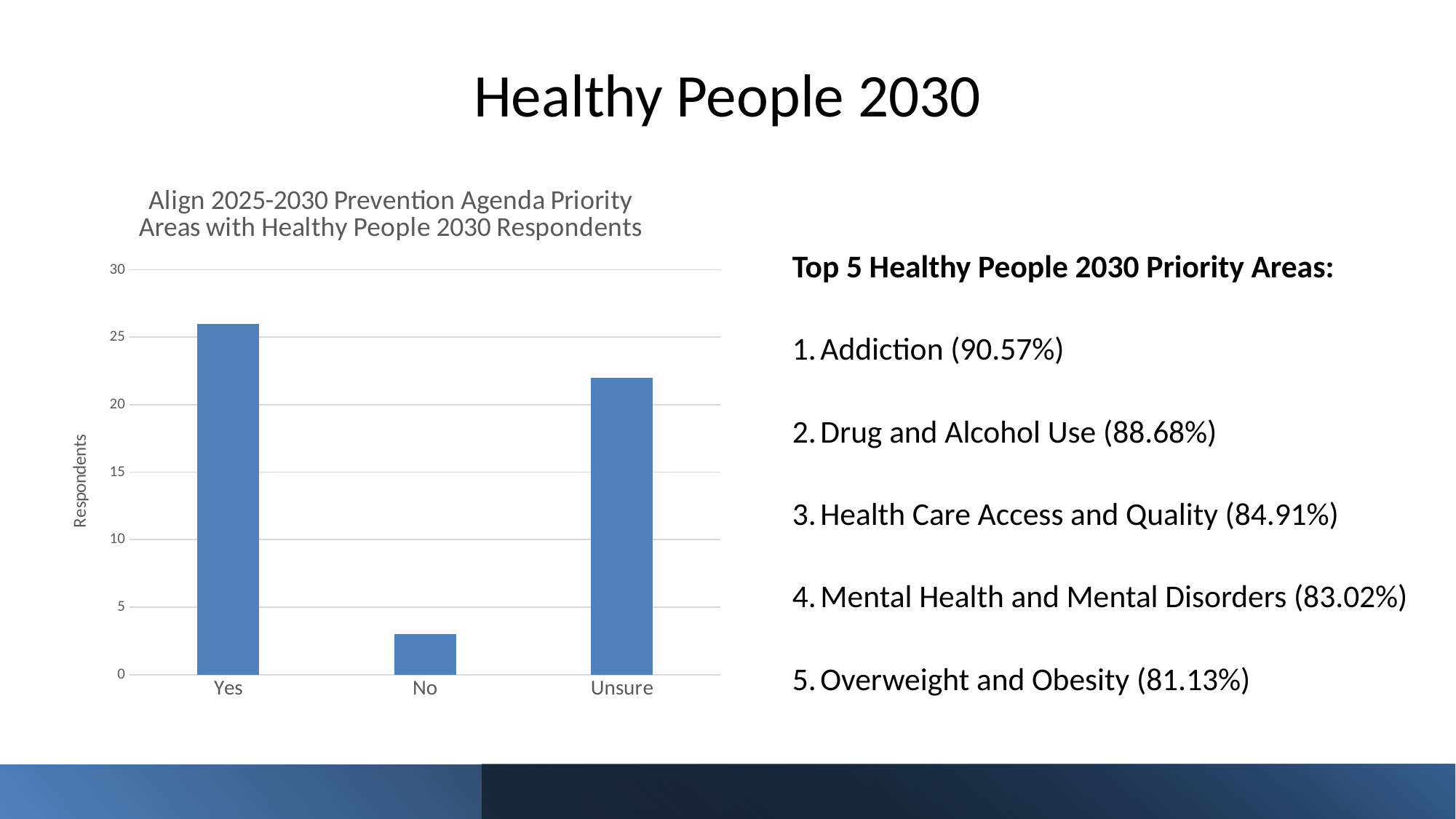
Is the value for No greater or less than 5? less Which is larger, the value for No or the value for Unsure? Unsure What is the label on the vertical axis of the chart? Respondents How many categories are shown on the x axis of the chart? 3 What kind of chart is shown on the slide? bar chart Is the value for Yes greater or less than 25? greater What is the title of the chart? Align 2025-2030 Prevention Agenda Priority Areas with Healthy People 2030 Respondents Is the value for Unsure greater or less than 20? greater Which category has the lowest number of respondents? No Which category has the highest number of respondents? Yes Which is larger, the value for Yes or the value for Unsure? Yes